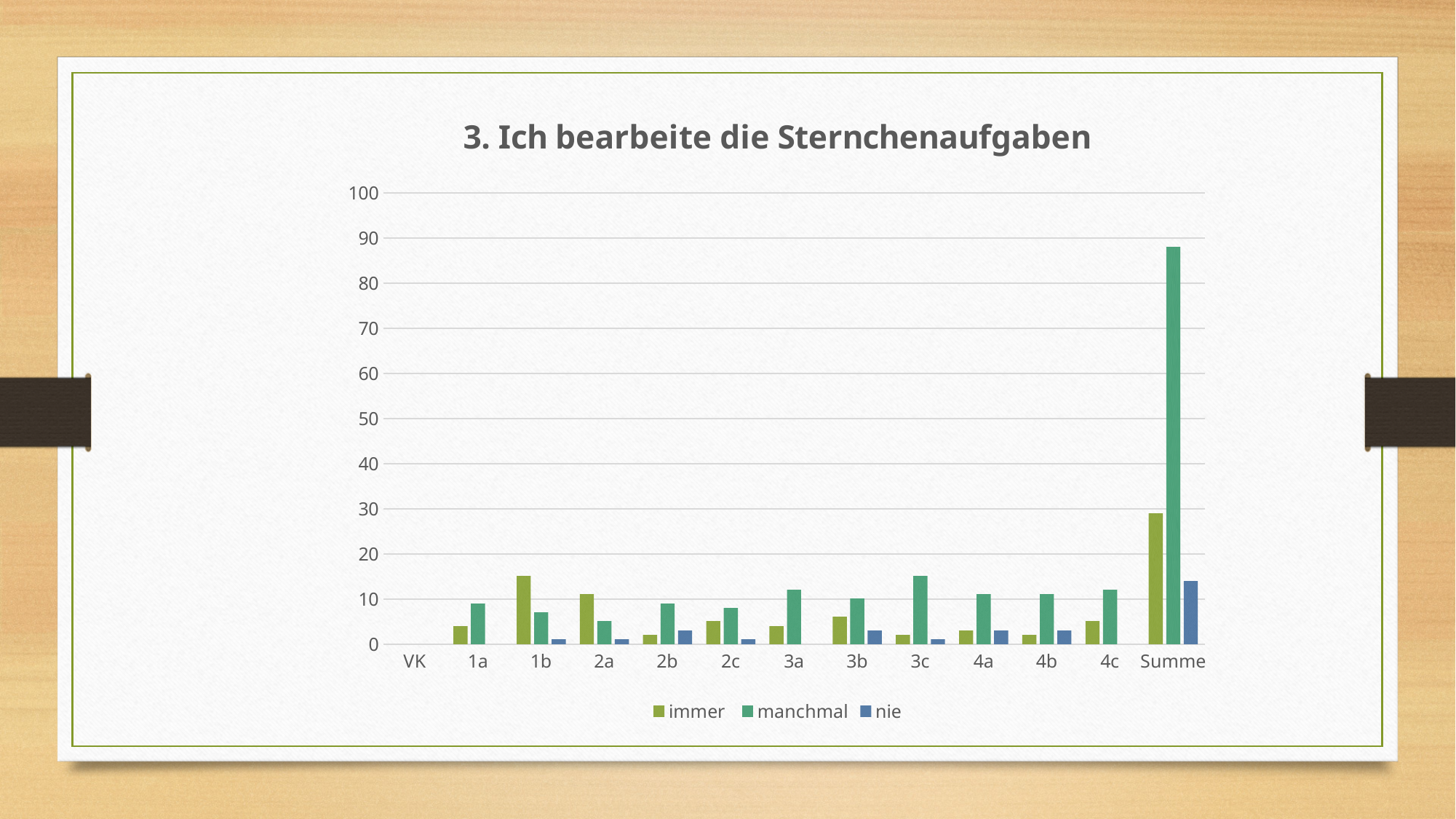
Which category has the highest value for the 'manchmal' series? Summe Is the 'immer' value for 1b greater or less than 10? greater Is the 'immer' value for 2b greater or less than 10? less Is the 'nie' value for Summe greater or less than 10? greater How many categories are shown on the x axis? 13 For category 1b, which is larger: the 'immer' value or the 'manchmal' value? immer For category 3c, which is larger: the 'immer' value or the 'manchmal' value? manchmal How many series does the legend list? 3 What kind of chart is shown on the slide? bar chart What is the title of the chart? 3. Ich bearbeite die Sternchenaufgaben